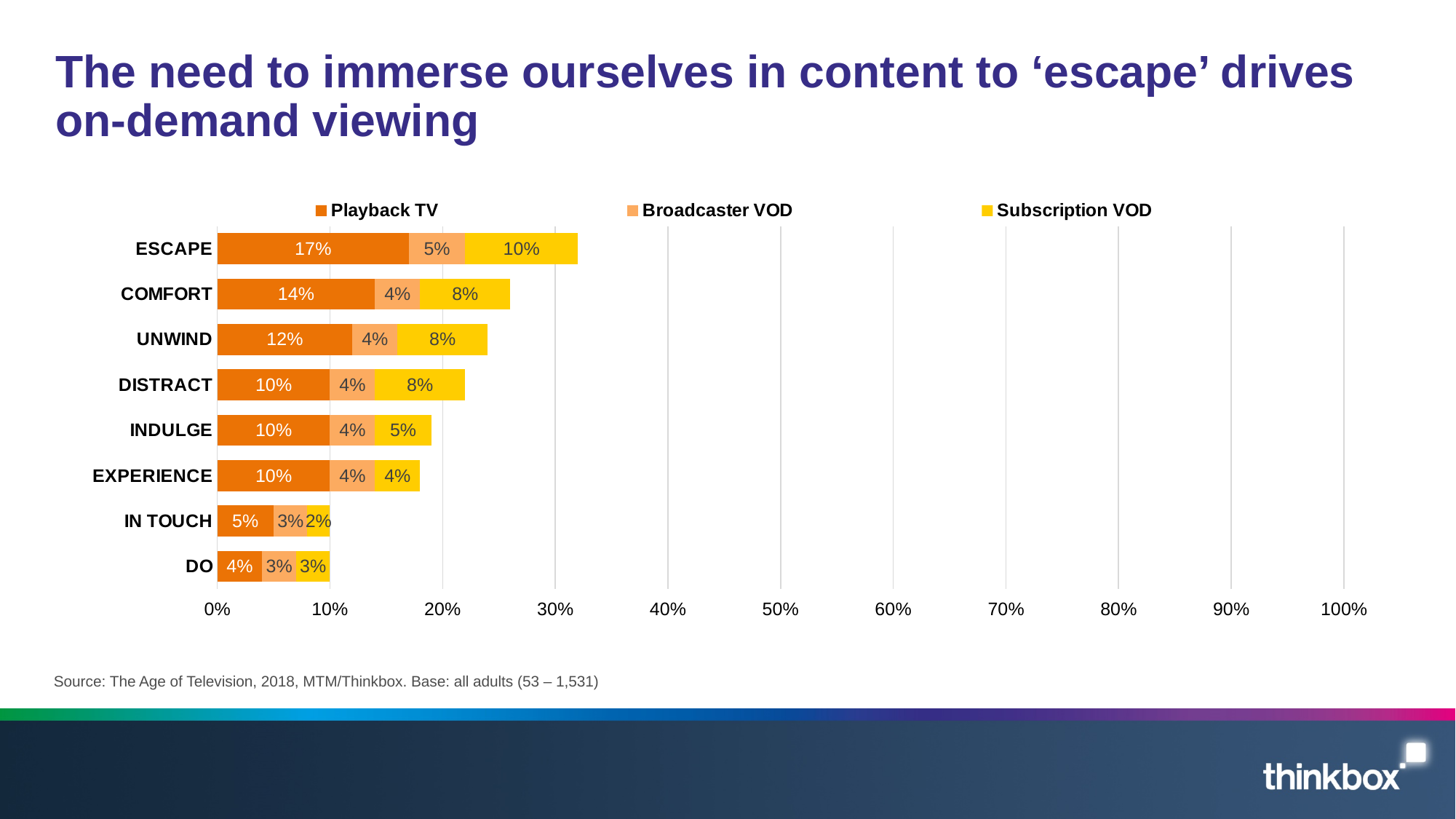
Which category has the highest Playback TV value? ESCAPE How many categories are shown on the chart? 8 Which is larger: the Subscription VOD value for INDULGE or for EXPERIENCE? INDULGE What kind of chart is shown on the slide? Stacked bar chart What is the total of the stacked bar for DO? 10% Which category has the lowest Subscription VOD value? IN TOUCH How many series does the legend list? 3 What is the difference between the Playback TV values for ESCAPE and COMFORT? 3% What is the Playback TV value for ESCAPE? 17% What is the Broadcaster VOD value for IN TOUCH? 3% What is the total of the stacked bar for ESCAPE? 32% What is the Subscription VOD value for COMFORT? 8%